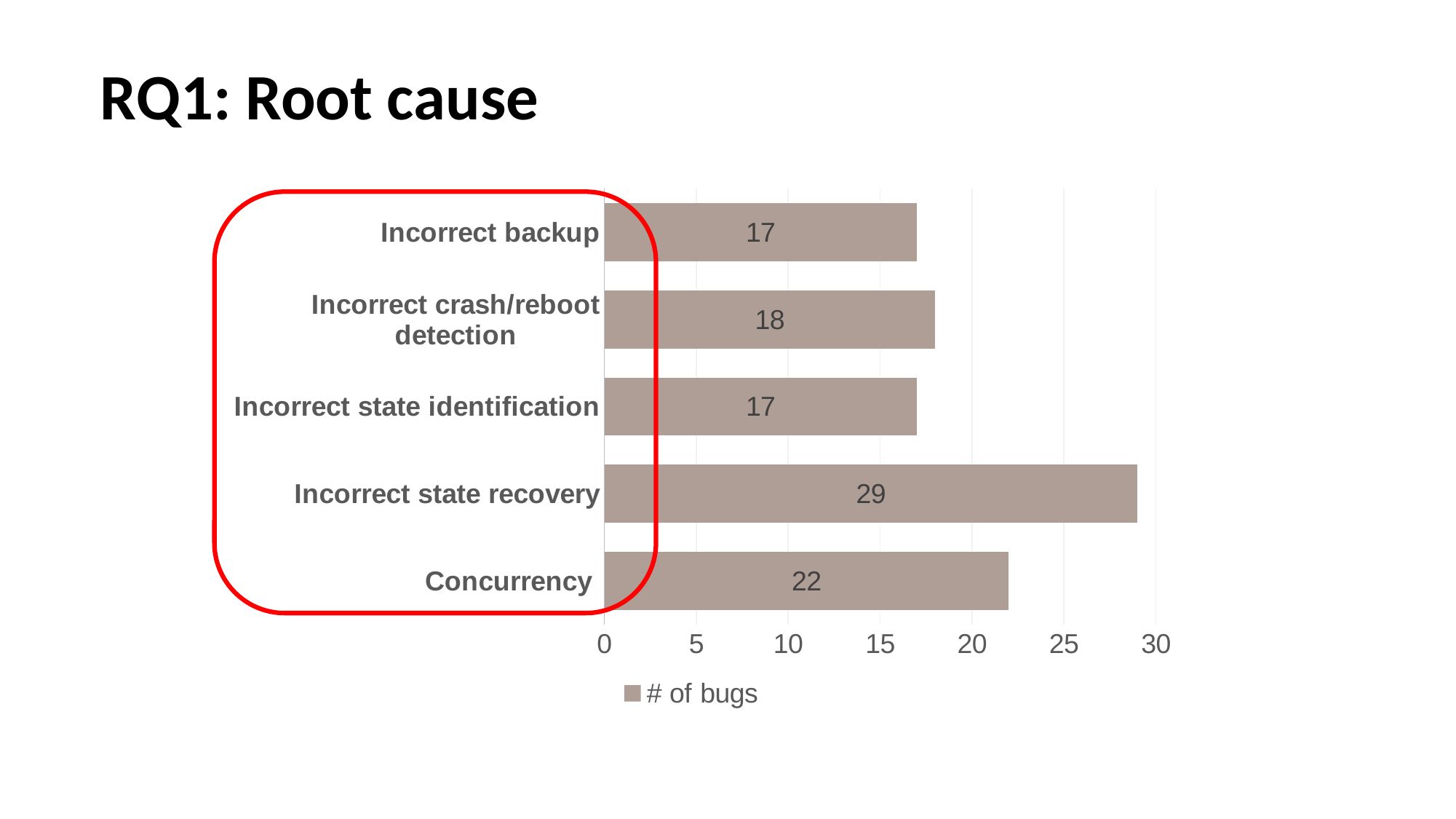
Which has more bugs, Concurrency or Incorrect state identification? Concurrency How many bugs are attributed to Incorrect state recovery? 29 Is the value for Incorrect state recovery greater or less than 25? greater Which root cause has the highest number of bugs? Incorrect state recovery How many bugs are attributed to Incorrect crash/reboot detection? 18 What is the difference in the number of bugs between Incorrect crash/reboot detection and Incorrect backup? 1 How many root cause categories are shown in the chart? 5 What is the difference in the number of bugs between Incorrect state recovery and Concurrency? 7 What kind of chart is shown on the slide? bar chart How many series does the legend list? 1 What is the number of bugs for Concurrency? 22 What is the legend entry for the series in the chart? # of bugs